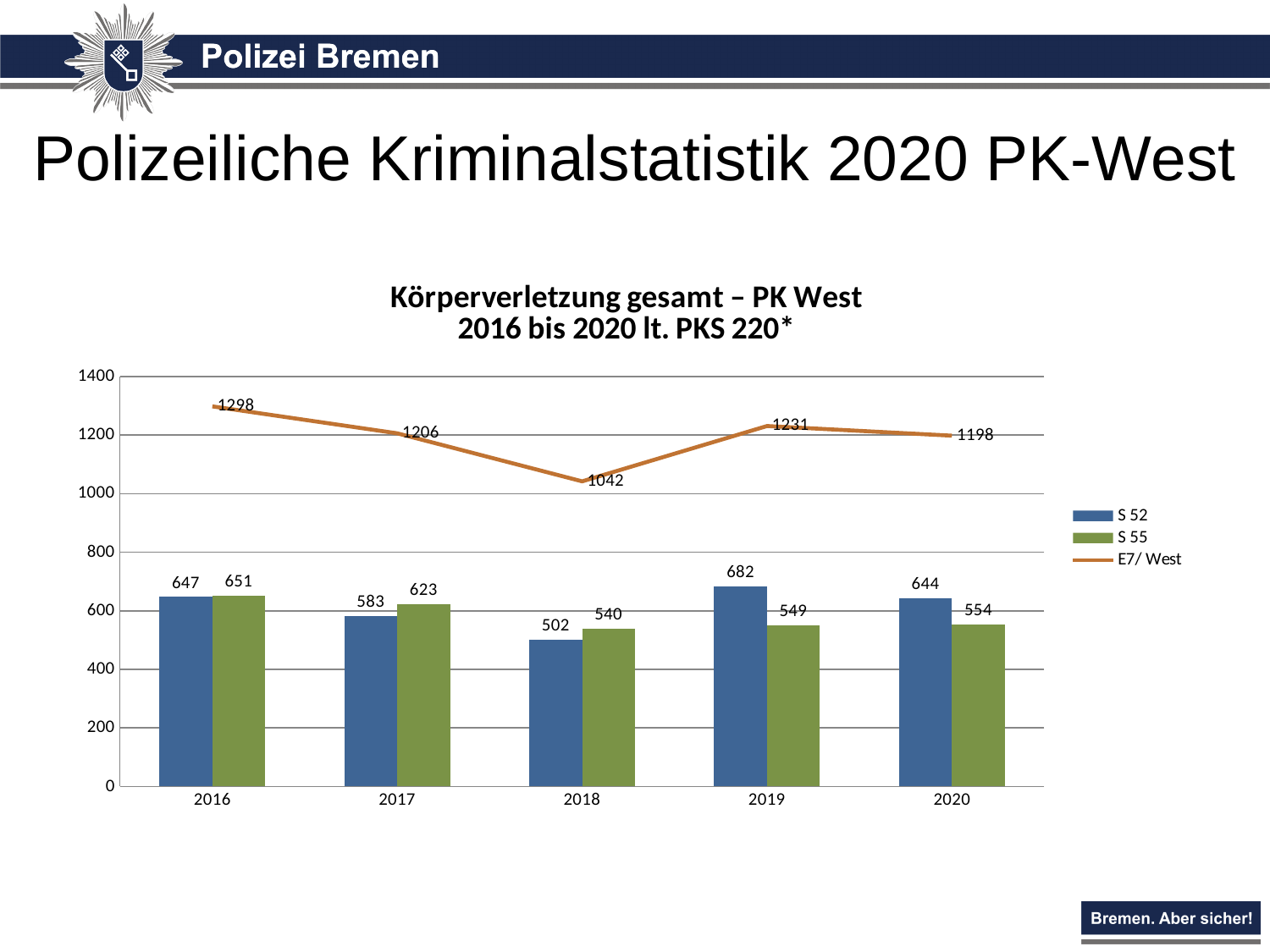
In which year is the E7/ West line highest? 2016 What is the value for S 55 in 2017? 623 How many years are shown on the x axis? 5 Which is larger in 2020, S 52 or S 55? S 52 What is the value for S 52 in 2019? 682 What kind of chart is this? Combined bar and line chart What is the title of the chart? Körperverletzung gesamt – PK West 2016 bis 2020 lt. PKS 220* Is the value for S 55 in 2018 greater or less than 600? less In which year is the S 52 value lowest? 2018 How many series does the legend list? 3 What is the value for E7/ West in 2018? 1042 What is the difference between the E7/ West values for 2016 and 2020? 100